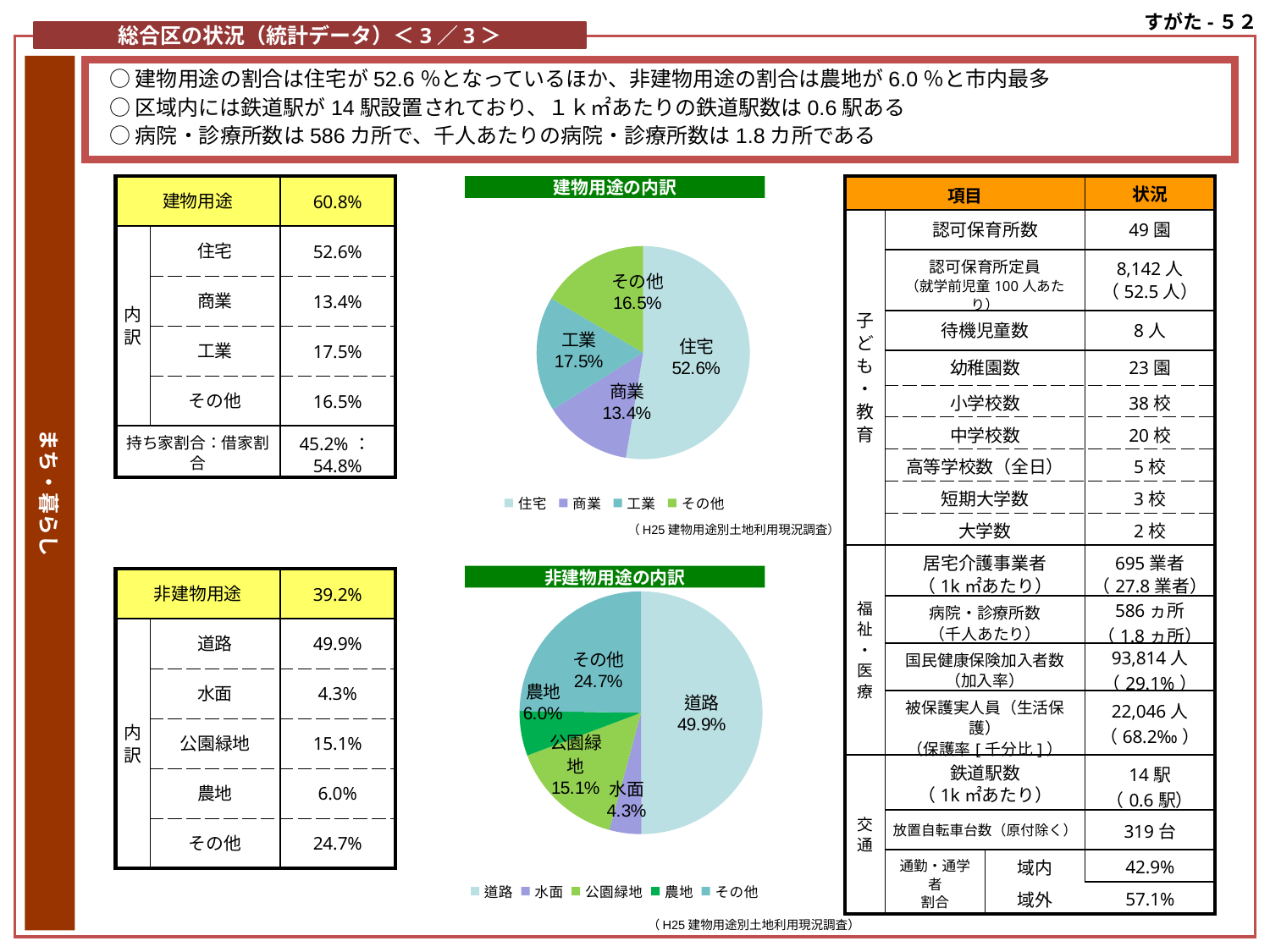
In the 建物用途の内訳 pie chart, how many categories does the legend list? 4 In the 建物用途の内訳 pie chart, what is the share for 工業? 17.5% In the 非建物用途の内訳 pie chart, what is the share for 農地? 6.0% In the 非建物用途の内訳 pie chart, which is larger, 公園緑地 or その他? その他 In the 建物用途の内訳 pie chart, what is the difference between the shares of 工業 and 商業? 4.1% In the 非建物用途の内訳 pie chart, what is the difference between the shares of その他 and 公園緑地? 9.6% What type of chart is the 建物用途の内訳 chart? Pie chart In the 建物用途の内訳 pie chart, which category has the smallest share? 商業 In the 建物用途の内訳 pie chart, what is the share for 住宅? 52.6% In the 非建物用途の内訳 pie chart, which category has the smallest share? 水面 In the 非建物用途の内訳 pie chart, how many categories does the legend list? 5 In the 非建物用途の内訳 pie chart, what is the share for 道路? 49.9%